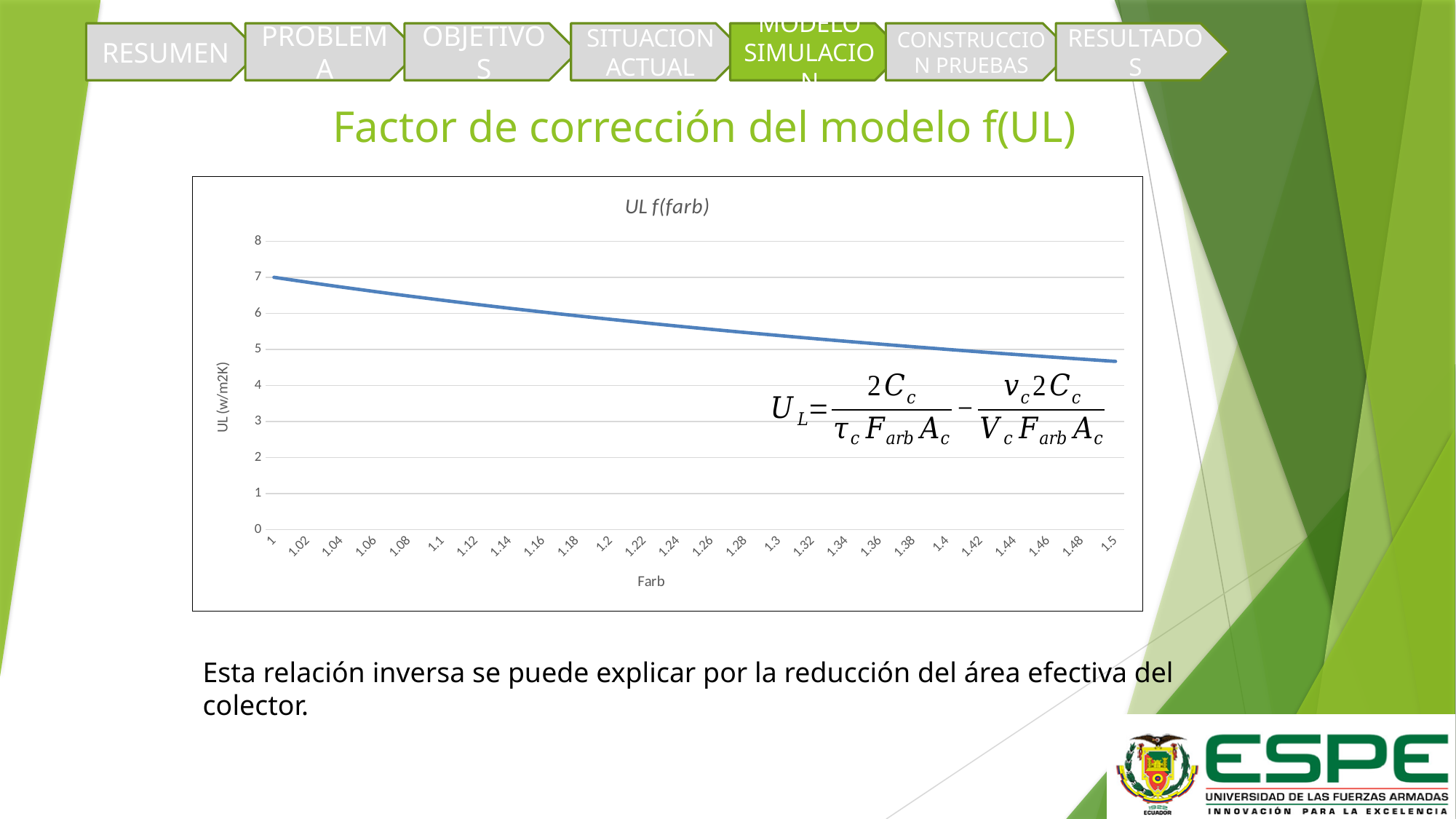
What kind of chart is shown on the slide? line chart At which Farb value is UL lowest? 1.5 At which Farb value is UL highest? 1 Is the UL value at Farb = 1.2 greater or less than 5? greater How many Farb tick labels are shown on the x axis? 26 Is the UL value at Farb = 1.4 greater or less than 6? less What is the title of the chart? UL f(farb) Do the UL values rise or fall as Farb increases along the x axis? fall Is the UL value at Farb = 1.5 greater or less than 5? less What is the label of the y axis? UL (w/m2K) Which has the larger UL value, Farb = 1 or Farb = 1.5? Farb = 1